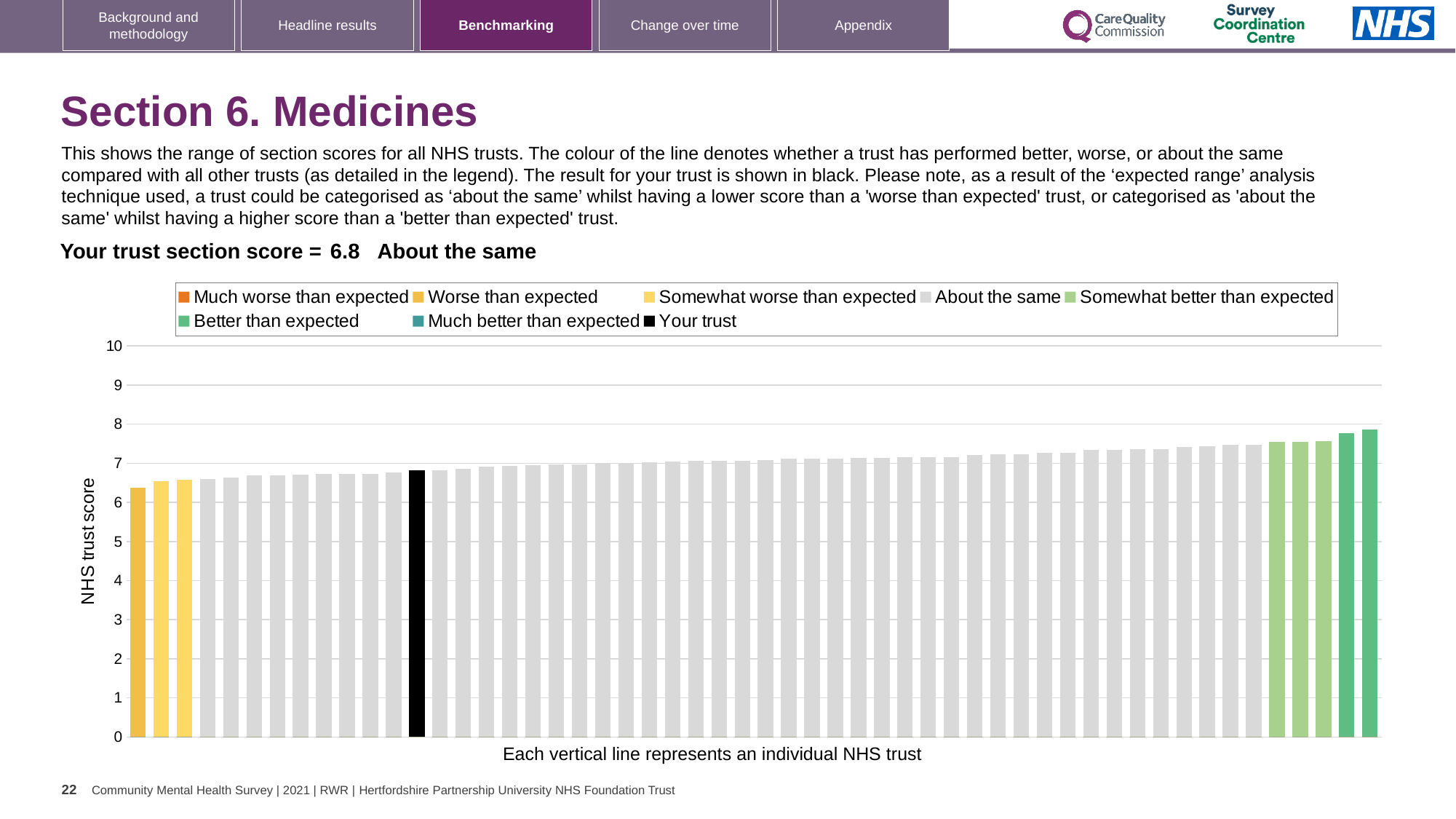
What is the section score for your trust shown on the slide? 6.8 Do the bar values rise or fall from left to right along the x axis? rise Which category is your trust placed in for the Medicines section? About the same Is the value of the shortest bar in the chart greater or less than 6? greater Is the value of the leftmost bar greater or less than 7? less What kind of chart is shown on the slide? Bar chart How many entries does the chart legend list? 8 What colour is used for the 'Your trust' bar in the chart? Black What is the label on the vertical axis of the chart? NHS trust score Is the value of the tallest bar in the chart greater or less than 8? less